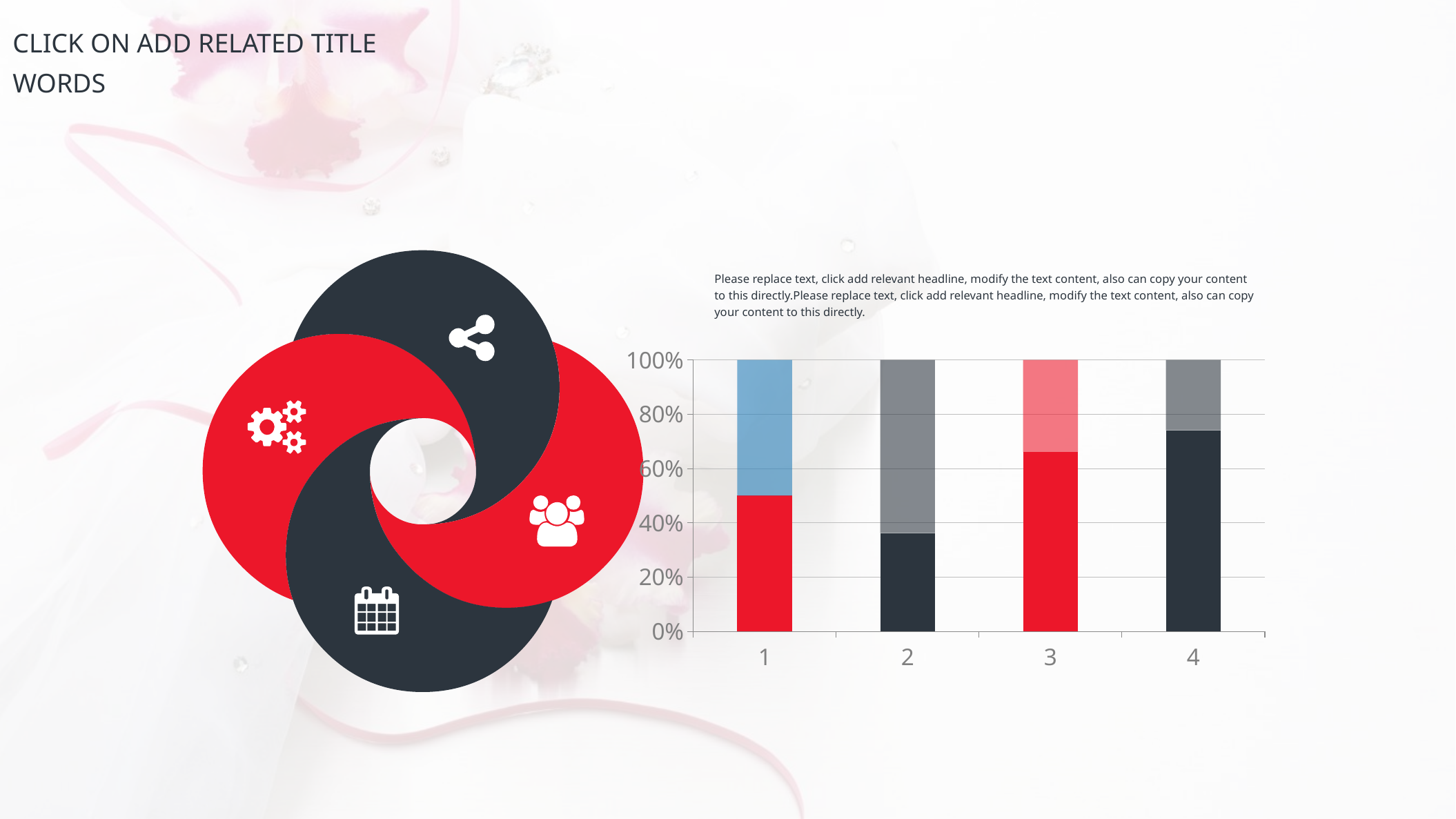
What colour is the bottom segment of the bar for category 3? red Which category has the shortest bottom segment in the stacked bar chart? 2 What is the total height of the stacked bar for category 4? 100% Is the bottom segment of the bar for category 3 greater or less than 60%? greater Is the bottom segment of the bar for category 1 greater or less than 40%? greater How many categories are shown on the x axis of the bar chart? 4 Which category has the tallest bottom segment in the stacked bar chart? 4 What is the total height of the stacked bar for category 1? 100% Which has the larger bottom segment, category 1 or category 3? category 3 Is the bottom segment of the bar for category 2 greater or less than 40%? less What kind of chart is shown on the right side of the slide? stacked bar chart